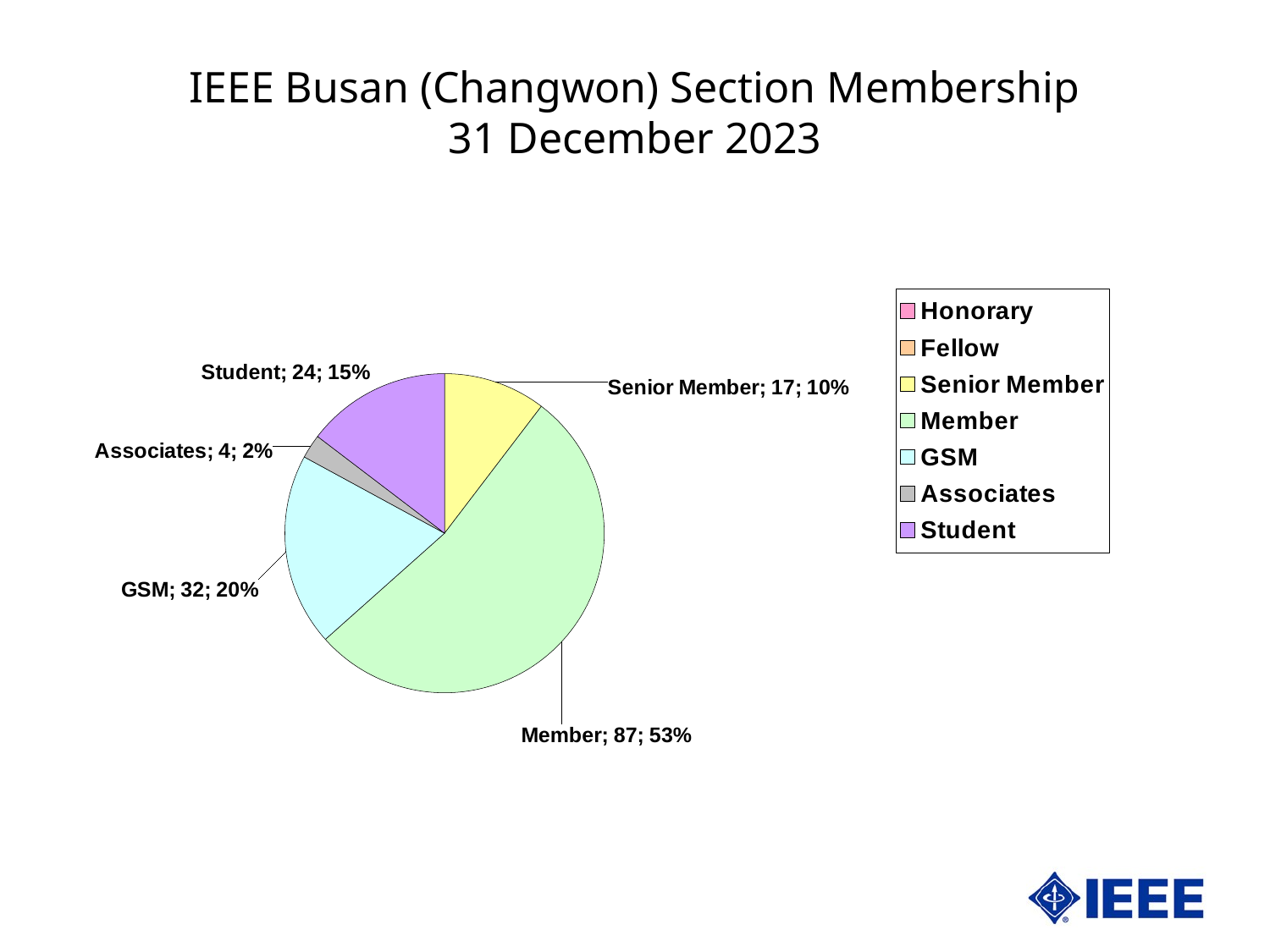
Which labelled category has the smallest slice of the pie? Associates What share of the pie does GSM represent? 20% How many entries does the legend list? 7 Which category has the largest slice of the pie? Member What kind of chart is shown on the slide? Pie chart What is the value for Associates? 4 What is the value for Senior Member? 17 What is the difference between the values for Member and GSM? 55 Which is larger, the value for Student or the value for Senior Member? Student What share of the pie does Student represent? 15% What is the value for GSM? 32 What is the value for Member? 87